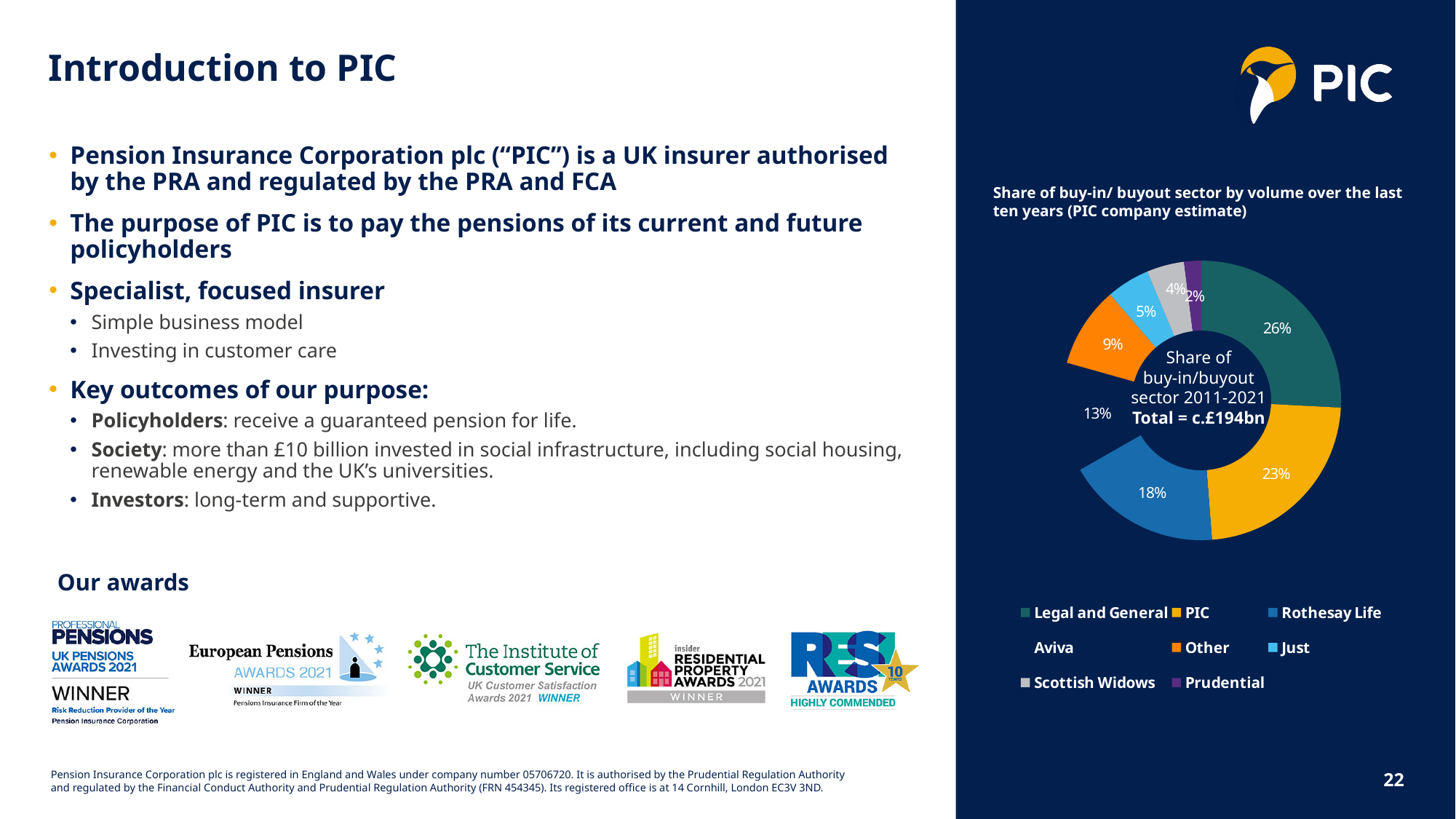
What share of the buy-in/buyout sector is attributed to Scottish Widows? 4% What share of the buy-in/buyout sector does Aviva hold? 13% How many companies or categories are shown in the chart legend? 8 What share of the buy-in/buyout sector does Legal and General hold? 26% What kind of chart is shown on the slide? Doughnut (pie) chart What share of the buy-in/buyout sector does Rothesay Life hold? 18% What is the total volume of the buy-in/buyout sector 2011-2021 stated in the centre of the chart? c.£194bn Which company has the largest share of the buy-in/buyout sector? Legal and General Which company has the smallest share of the buy-in/buyout sector? Prudential Which has a larger share of the buy-in/buyout sector, Rothesay Life or Aviva? Rothesay Life What share of the buy-in/buyout sector does PIC hold? 23% What is the difference in percentage points between Legal and General's share and PIC's share? 3 percentage points